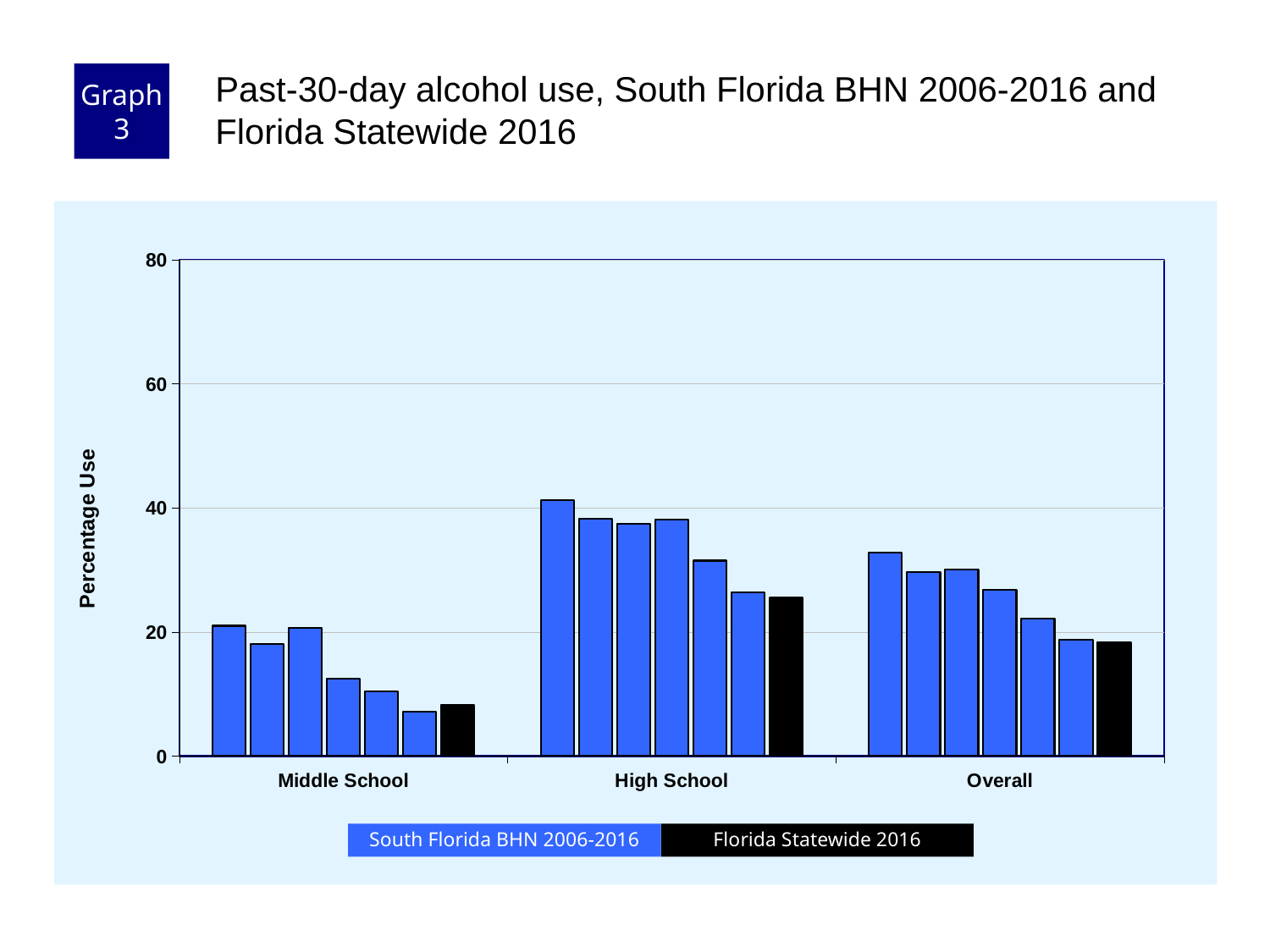
How many school-level categories are shown on the x axis? 3 How many series does the legend list? 2 How many South Florida BHN 2006-2016 bars are shown for each category? 6 What is the label on the y axis? Percentage Use Is the Florida Statewide 2016 bar for High School higher or lower than the Florida Statewide 2016 bar for Overall? higher Do the South Florida BHN bars for High School rise or fall from 2006 to 2016? fall Is the tallest High School bar greater or less than 60? less Which category has the highest bars overall? High School Is the Florida Statewide 2016 value for High School greater or less than 20? greater Is the Florida Statewide 2016 value for Middle School greater or less than 20? less Which category has the lowest bars overall? Middle School What kind of chart is shown on the slide? bar chart